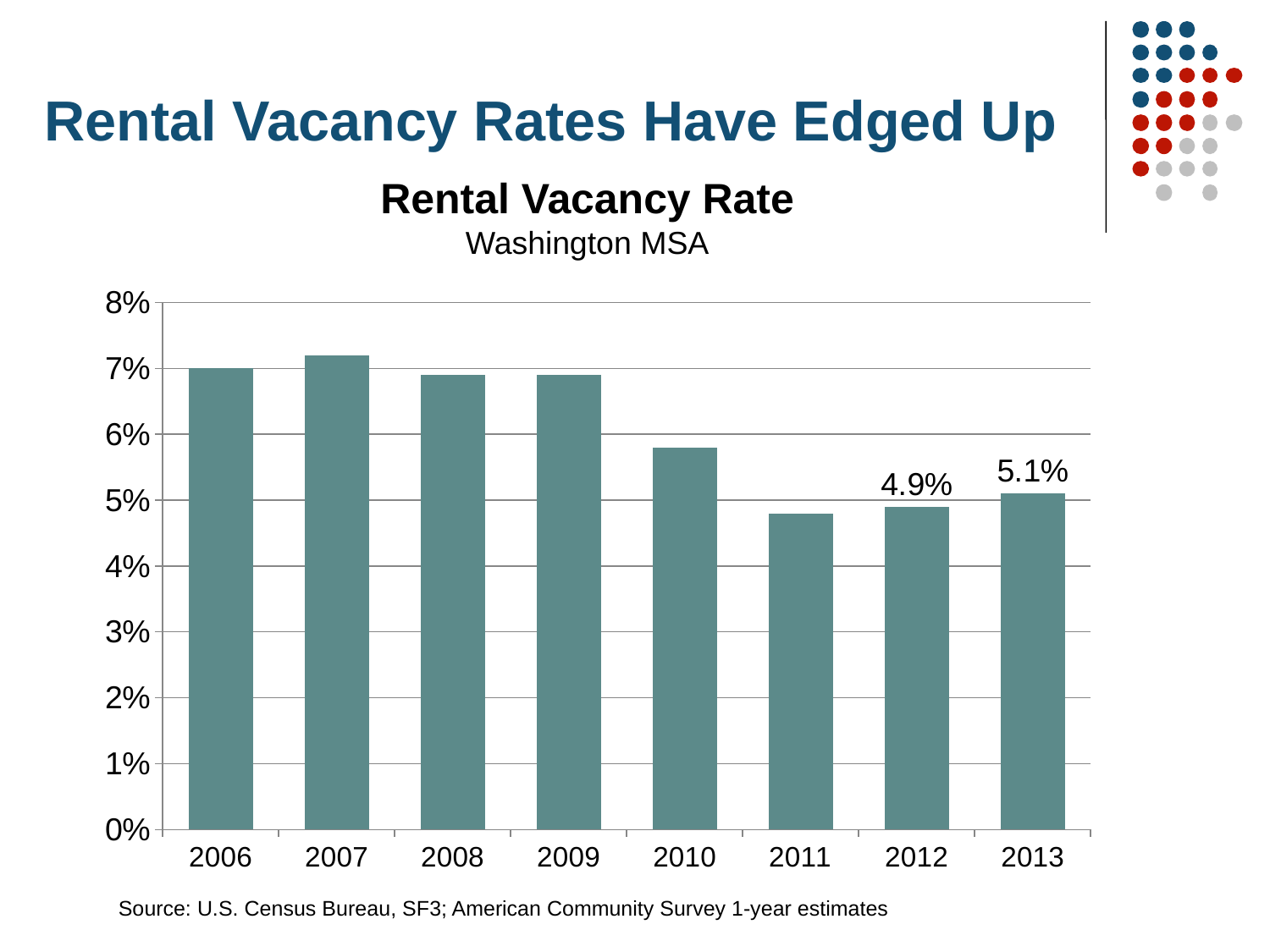
How many years are shown on the x axis? 8 Which metropolitan area does the chart cover, according to its subtitle? Washington MSA Is the value for 2010 greater or less than 5%? greater Which year has the highest rental vacancy rate? 2007 What is the rental vacancy rate for 2013? 5.1% Do the rental vacancy rates generally rise or fall from 2006 to 2011? fall By how many percentage points did the rental vacancy rate change from 2012 to 2013? 0.2 percentage points Is the value for 2011 greater or less than 6%? less Which year has the higher rental vacancy rate, 2012 or 2013? 2013 What kind of chart is shown on the slide? bar chart Is the value for 2006 greater or less than 6%? greater What is the rental vacancy rate for 2012? 4.9%